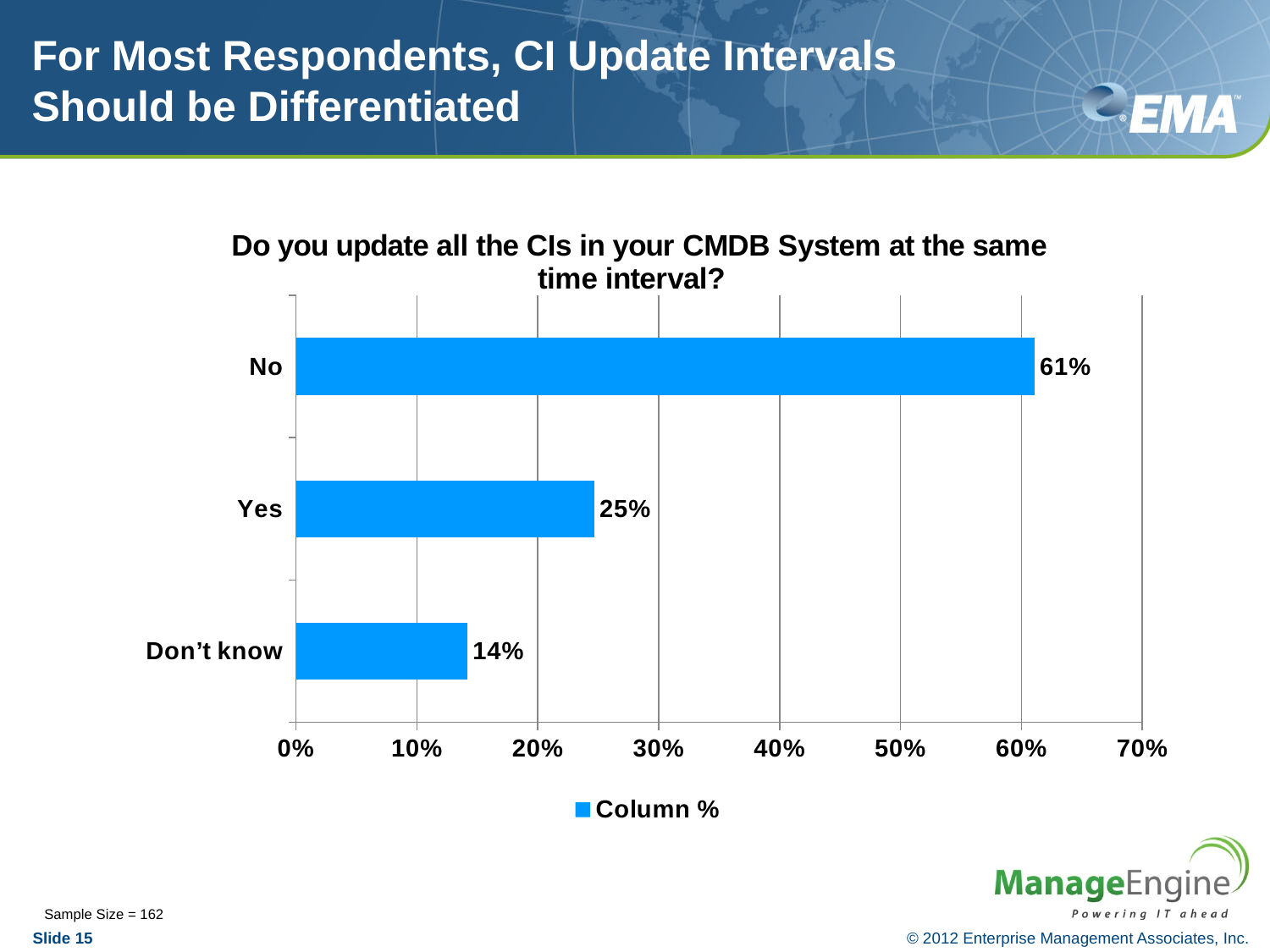
How many response categories are shown in the chart? 3 What is the difference in percentage points between "No" and "Yes"? 36% Is the value for "No" greater or less than 50%? greater What percentage of respondents answered "Yes"? 25% Which response has the lowest percentage? Don't know What percentage of respondents answered "Don't know"? 14% What type of chart is shown on the slide? Bar chart What is the difference in percentage points between "Yes" and "Don't know"? 11% Which is larger, the value for "Yes" or the value for "Don't know"? Yes Which response has the highest percentage? No What percentage of respondents answered "No"? 61% What is the name of the series listed in the legend? Column %